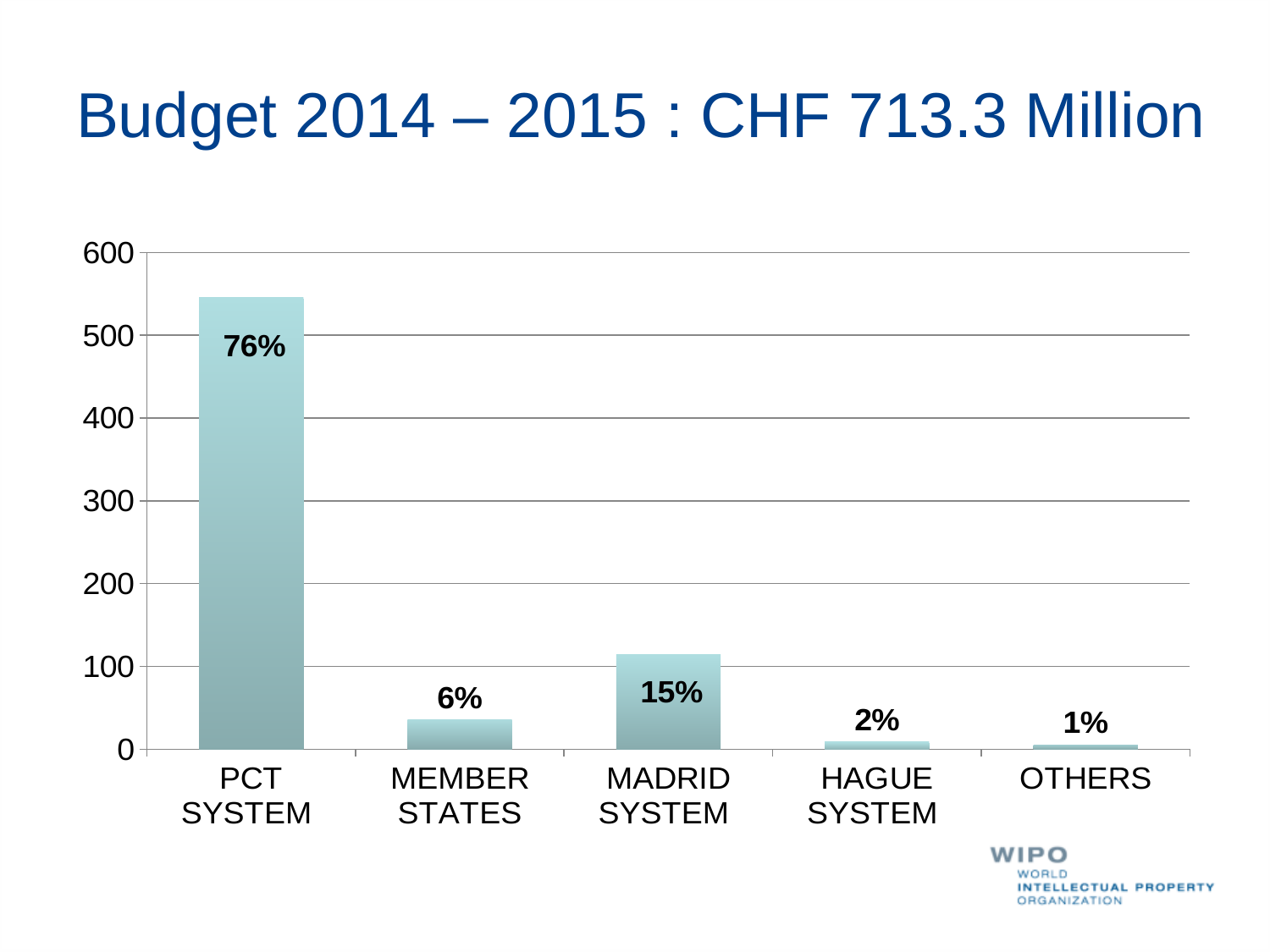
Which category has the highest bar? PCT SYSTEM Which category has the lowest bar? OTHERS What percentage label is shown on the MADRID SYSTEM bar? 15% Is the value for MEMBER STATES greater or less than 100? less Which is larger, the bar for MADRID SYSTEM or the bar for MEMBER STATES? MADRID SYSTEM What kind of chart is shown on the slide? Bar chart What percentage label is shown on the HAGUE SYSTEM bar? 2% What percentage label is shown on the PCT SYSTEM bar? 76% How many categories are shown on the x axis? 5 Is the value for PCT SYSTEM greater or less than 500? greater What percentage label is shown on the MEMBER STATES bar? 6% What is the title of the slide containing the chart? Budget 2014 – 2015 : CHF 713.3 Million